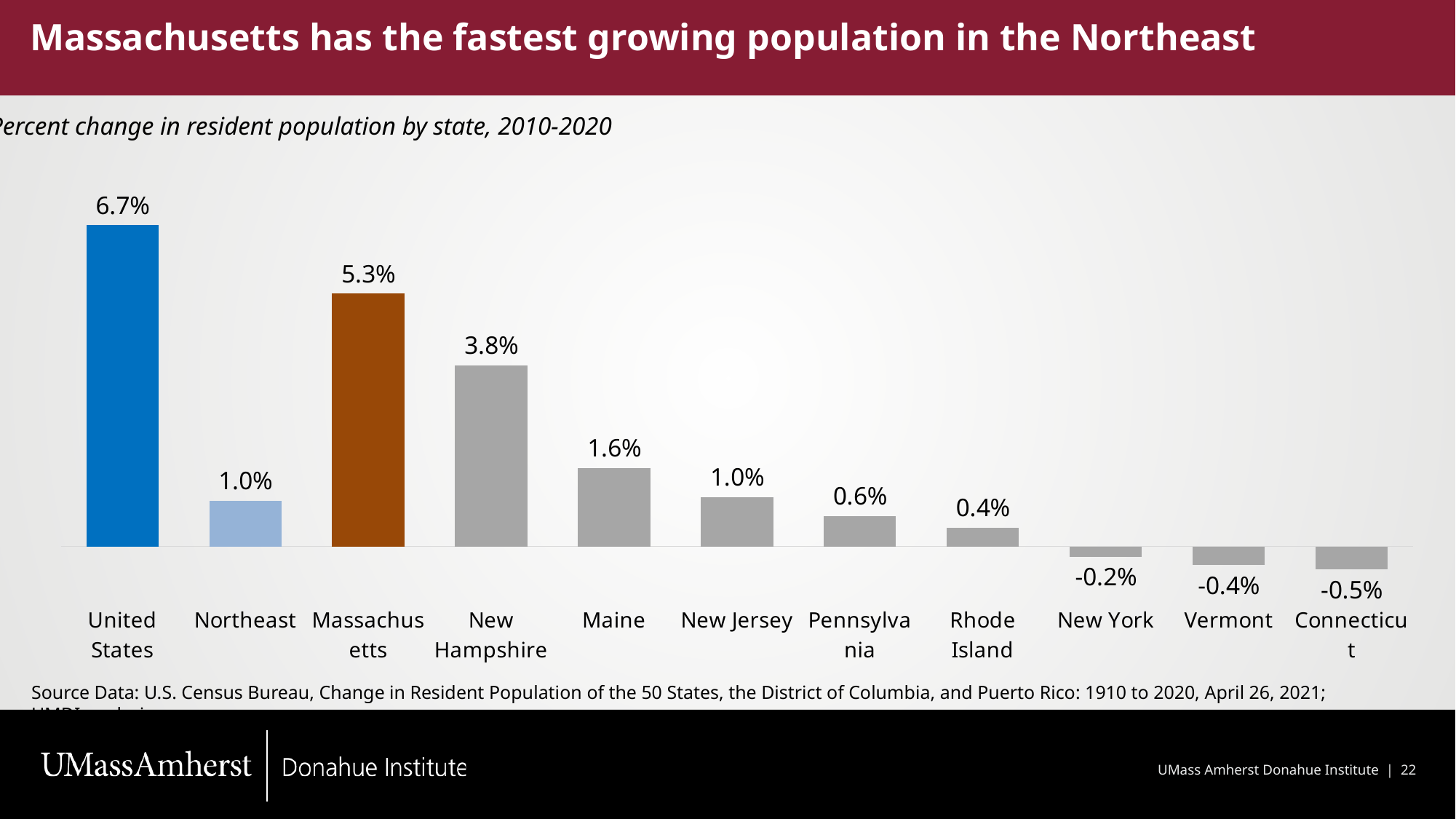
What is the percent change in resident population for New Hampshire? 3.8% What is the subtitle of the chart? Percent change in resident population by state, 2010-2020 What is the percent change in resident population for Massachusetts? 5.3% Which has a larger percent change in resident population, Maine or New Jersey? Maine How many categories show a negative percent change? 3 What kind of chart is shown on the slide? Bar chart What is the percent change in resident population for Connecticut? -0.5% What is the percent change in resident population for the Northeast? 1.0% How many categories are shown on the chart? 11 Which category has the lowest percent change in resident population? Connecticut Which category has the highest percent change in resident population? United States What is the difference between the percent change for the United States and for Massachusetts? 1.4%